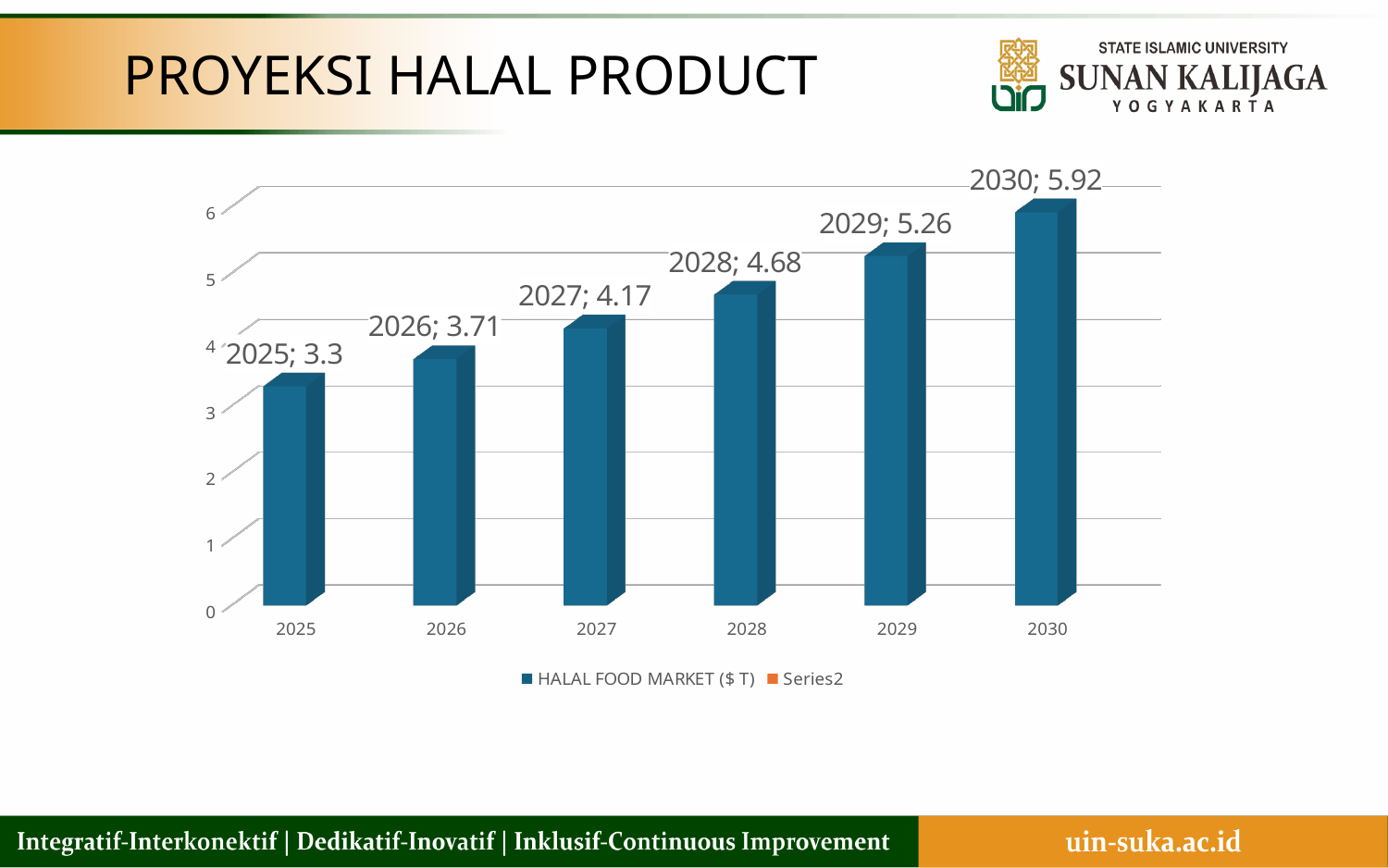
Which year has the lowest value? 2025 What kind of chart is shown on the slide? bar chart What is the difference between the values for 2030 and 2025? 2.62 How many years are shown on the x axis? 6 Do the values rise or fall from 2025 to 2030? rise Is the value for 2029 greater or less than 5? greater What is the value for 2028? 4.68 Which is larger, the value for 2029 or the value for 2027? 2029 Which year has the highest value? 2030 What is the value for 2030? 5.92 What is the value for 2025? 3.3 What is the difference between the values for 2027 and 2026? 0.46